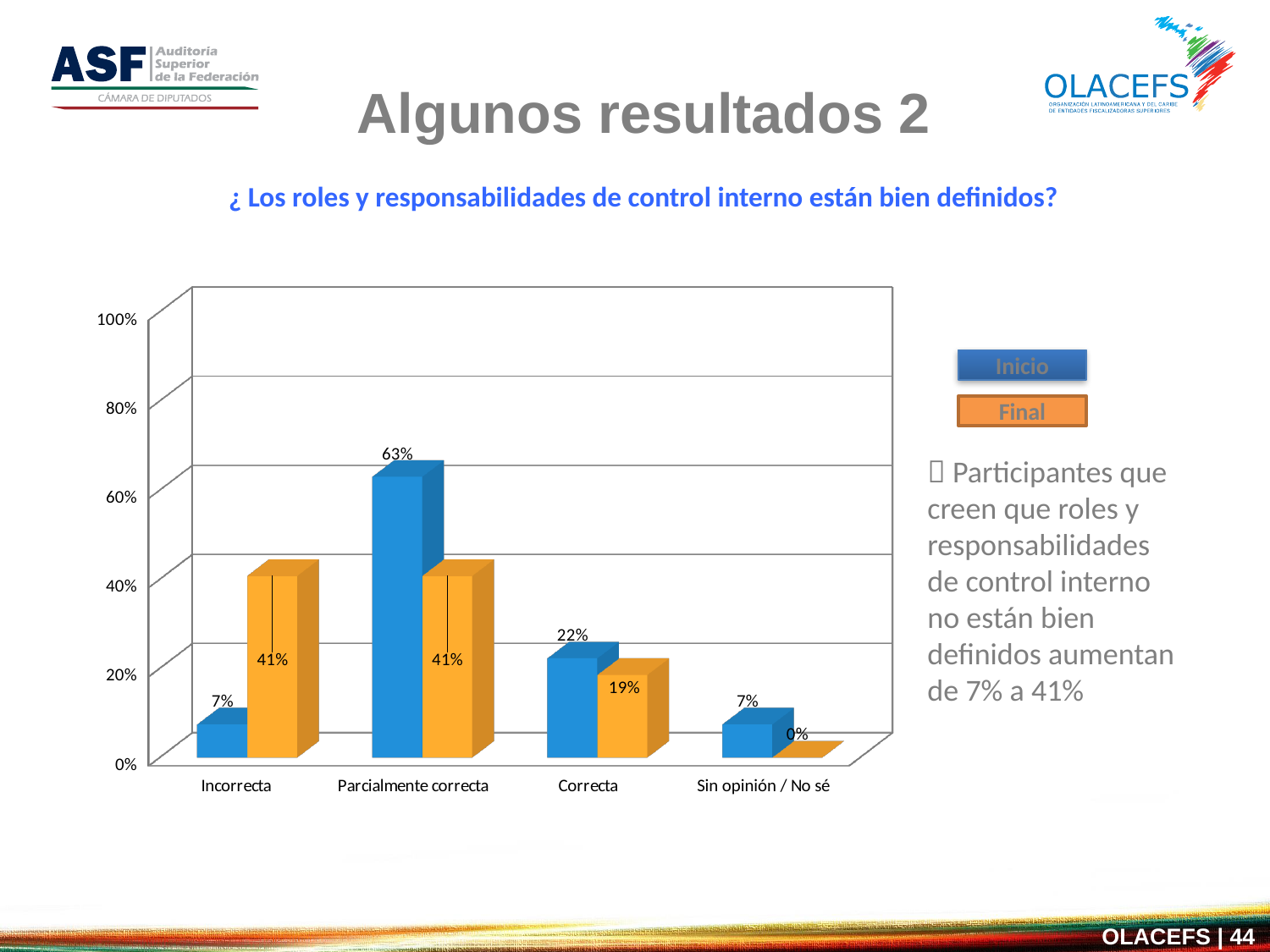
What is the Inicio value for Sin opinión / No sé? 7% What kind of chart is shown on the slide? Bar chart How many categories are shown on the x axis? 4 What is the Inicio value for Parcialmente correcta? 63% What is the difference between the Inicio and Final values for Incorrecta? 34% Which category has the highest Inicio value? Parcialmente correcta What is the Final value for Incorrecta? 41% Which colour represents the Final series? Orange Which is larger for Correcta, the Inicio value or the Final value? Inicio What is the Final value for Correcta? 19% How many series does the legend list? 2 Which category has the lowest Final value? Sin opinión / No sé